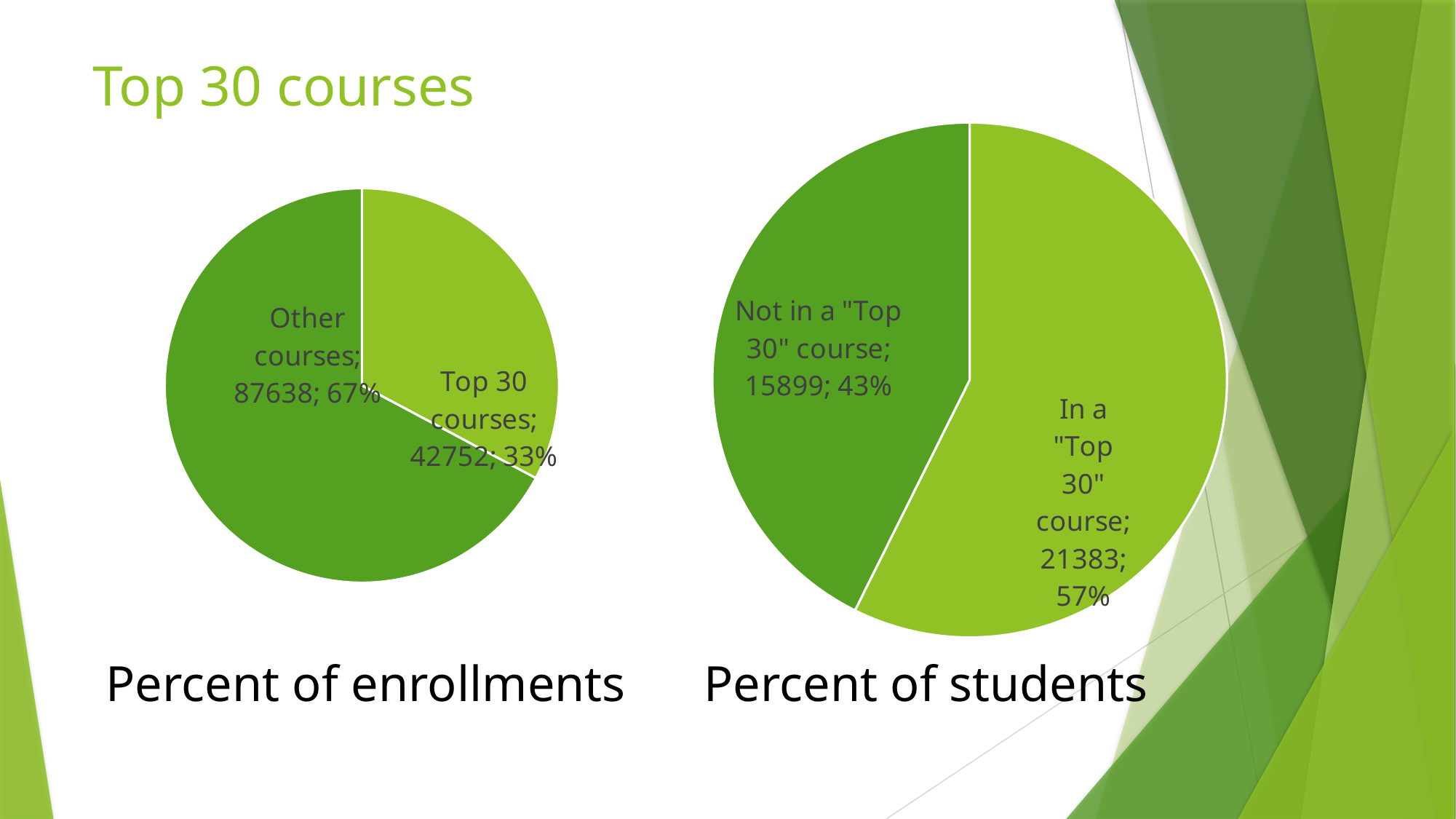
In the 'Percent of students' pie chart, what is the value for students not in a "Top 30" course? 15899 In the 'Percent of enrollments' pie chart, what share of the pie is Other courses? 67% What kind of chart is the 'Percent of students' chart? Pie chart In the 'Percent of enrollments' pie chart, which slice is the smallest? Top 30 courses In the 'Percent of students' pie chart, what share of the pie is 'In a "Top 30" course'? 57% In the 'Percent of enrollments' pie chart, what is the value for Top 30 courses? 42752 In the 'Percent of students' pie chart, what is the total of the two slices? 37282 In the 'Percent of students' pie chart, which slice is the largest? In a "Top 30" course In the 'Percent of students' pie chart, what is the value for students in a "Top 30" course? 21383 In the 'Percent of enrollments' pie chart, what is the difference between Other courses and Top 30 courses? 44886 In the 'Percent of enrollments' pie chart, what share of the pie is Top 30 courses? 33% In the 'Percent of enrollments' pie chart, what is the value for Other courses? 87638